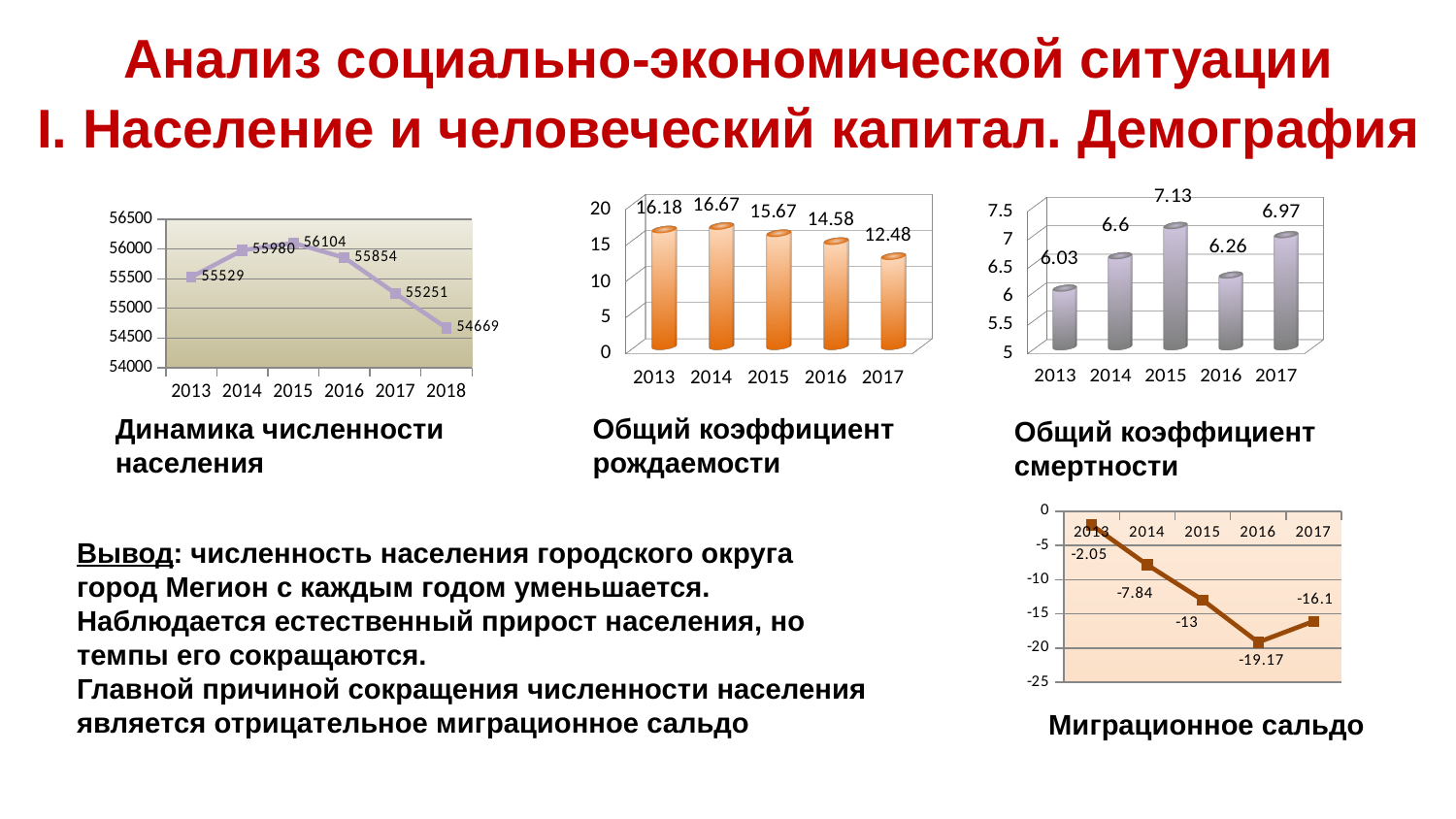
In the 'Динамика численности населения' chart, which year has the lowest value? 2018 In the 'Общий коэффициент рождаемости' chart, what is the value for 2017? 12.48 In the 'Общий коэффициент рождаемости' chart, do the values generally rise or fall from 2014 to 2017? fall In the 'Общий коэффициент рождаемости' chart, which year has the highest value? 2014 How many years are plotted in the 'Динамика численности населения' chart? 6 In the 'Миграционное сальдо' chart, what is the value for 2016? -19.17 In the 'Общий коэффициент смертности' chart, which is larger, the value for 2014 or the value for 2016? 2014 In the 'Динамика численности населения' chart, what is the difference between the 2013 and 2018 values? 860 In the 'Динамика численности населения' chart, what is the value for 2015? 56104 What kind of chart is the 'Общий коэффициент смертности' chart? bar chart In the 'Общий коэффициент смертности' chart, which year has the highest value? 2015 In the 'Миграционное сальдо' chart, what is the difference between the 2013 and 2014 values? 5.79